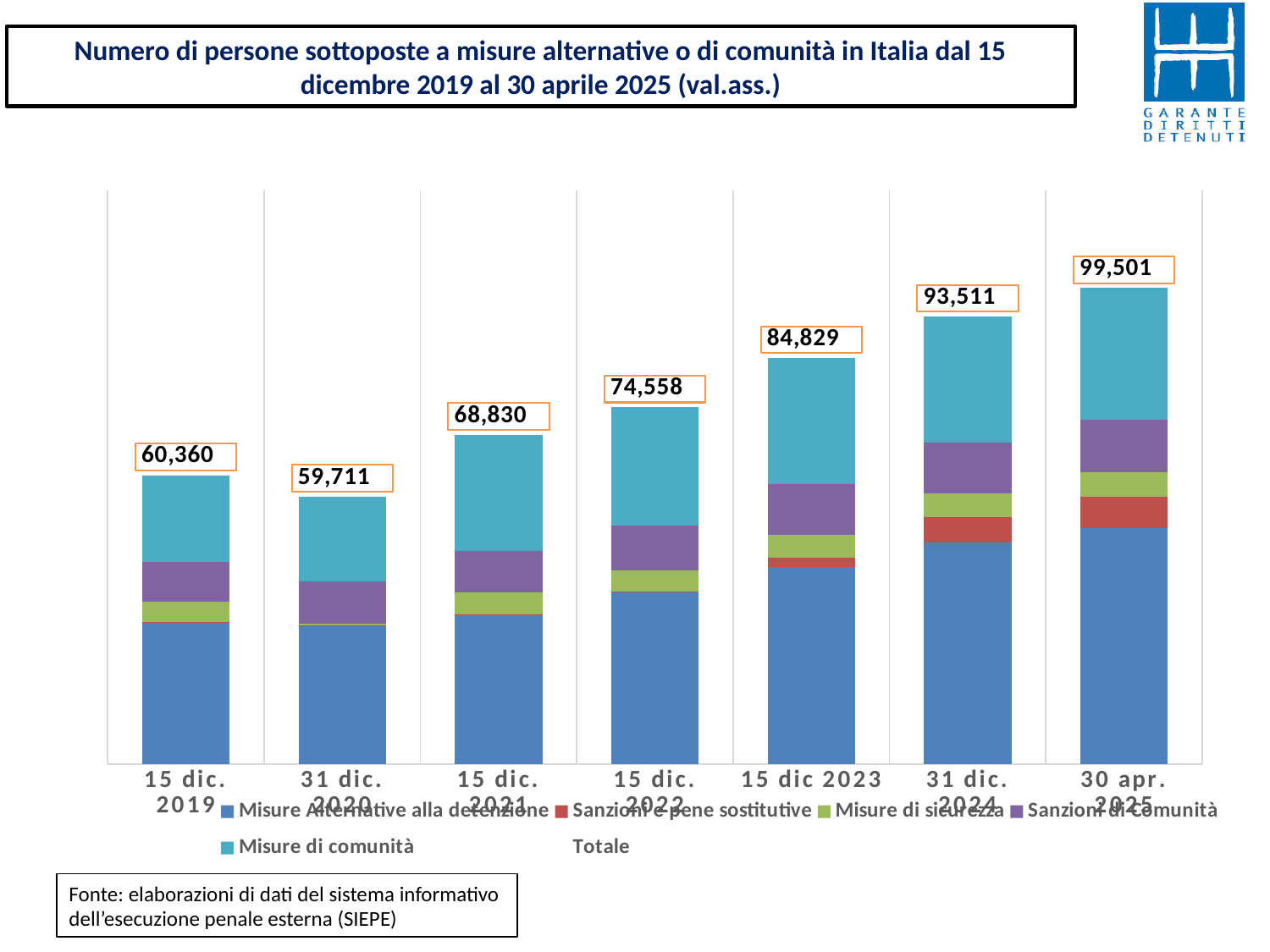
What is the total number of people shown for 15 dic 2023? 84,829 How many dates (bars) are shown on the x axis? 7 What is the total number of people shown for 30 apr. 2025? 99,501 Which date has the highest total? 30 apr. 2025 What is the difference between the totals for 15 dic. 2022 and 15 dic. 2021? 5,728 What is the total number of people shown for 15 dic. 2019? 60,360 What is the total number of people shown for 31 dic. 2020? 59,711 Which is larger, the total for 15 dic. 2019 or the total for 31 dic. 2020? 15 dic. 2019 Which date has the lowest total? 31 dic. 2020 What is the difference between the totals for 30 apr. 2025 and 31 dic. 2024? 5,990 What kind of chart is shown on the slide? Stacked bar chart How many entries does the legend list? 6